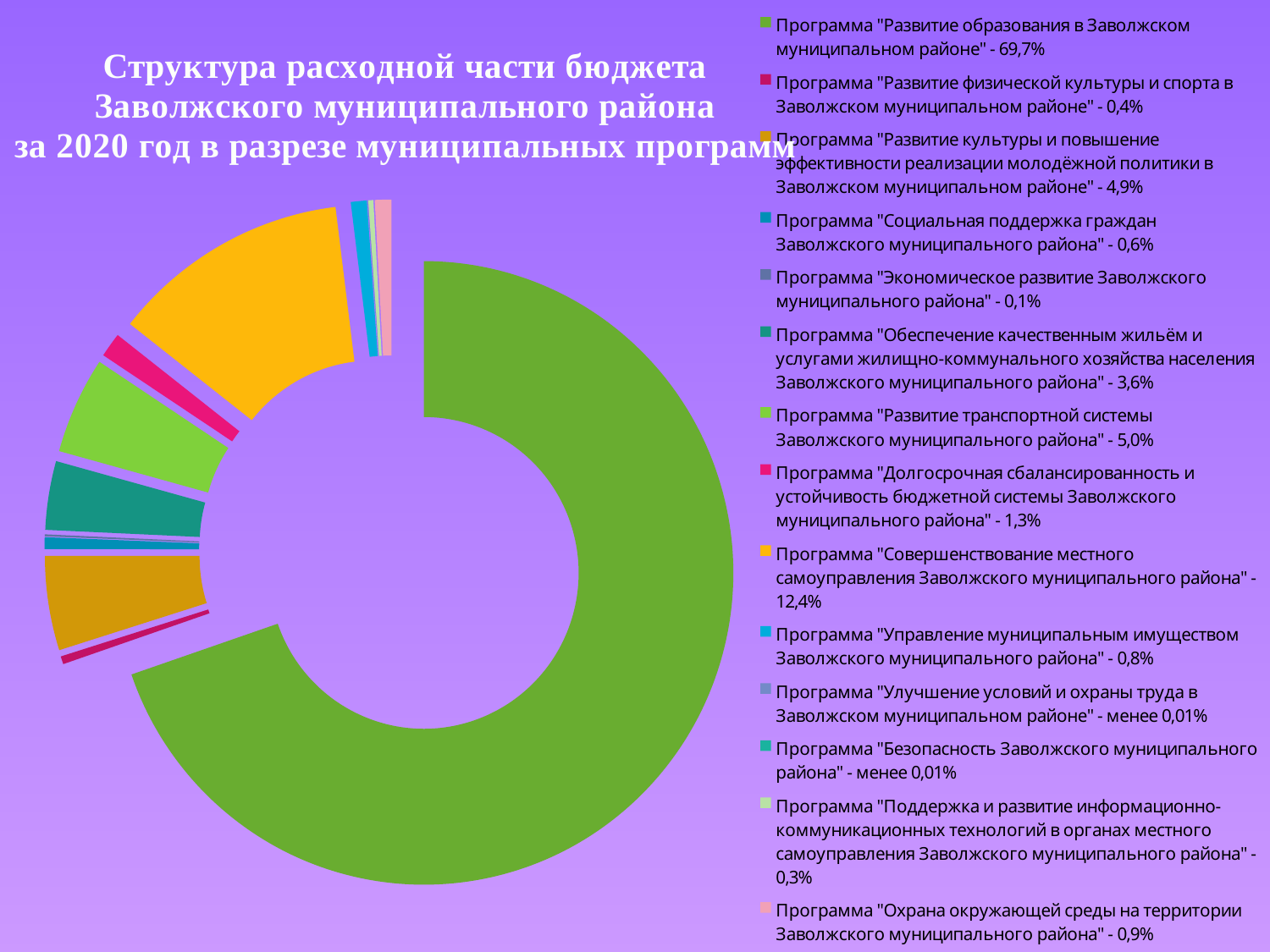
What share is shown for the programme "Развитие транспортной системы Заволжского муниципального района"? 5,0% What type of chart is shown on the slide? Pie (doughnut) chart What share of the budget expenditure goes to the programme "Развитие образования в Заволжском муниципальном районе"? 69,7% What share is shown for the programme "Обеспечение качественным жильём и услугами жилищно-коммунального хозяйства населения Заволжского муниципального района"? 3,6% What share is shown for the programme "Совершенствование местного самоуправления Заволжского муниципального района"? 12,4% What year does the chart title say the budget expenditure structure refers to? 2020 How many municipal programmes are listed in the chart legend? 14 Which has the larger share: the programme "Развитие транспортной системы" or the programme "Развитие культуры и повышение эффективности реализации молодёжной политики"? Программа "Развитие транспортной системы" (5,0%) What share is shown for the programme "Охрана окружающей среды на территории Заволжского муниципального района"? 0,9% Which programme has the largest share of the budget expenditure? Программа "Развитие образования в Заволжском муниципальном районе" What is the difference in share between the programme "Развитие образования" (69,7%) and the programme "Совершенствование местного самоуправления" (12,4%)? 57,3 percentage points Which has the larger share: the programme "Социальная поддержка граждан" or the programme "Управление муниципальным имуществом"? Программа "Управление муниципальным имуществом" (0,8%)